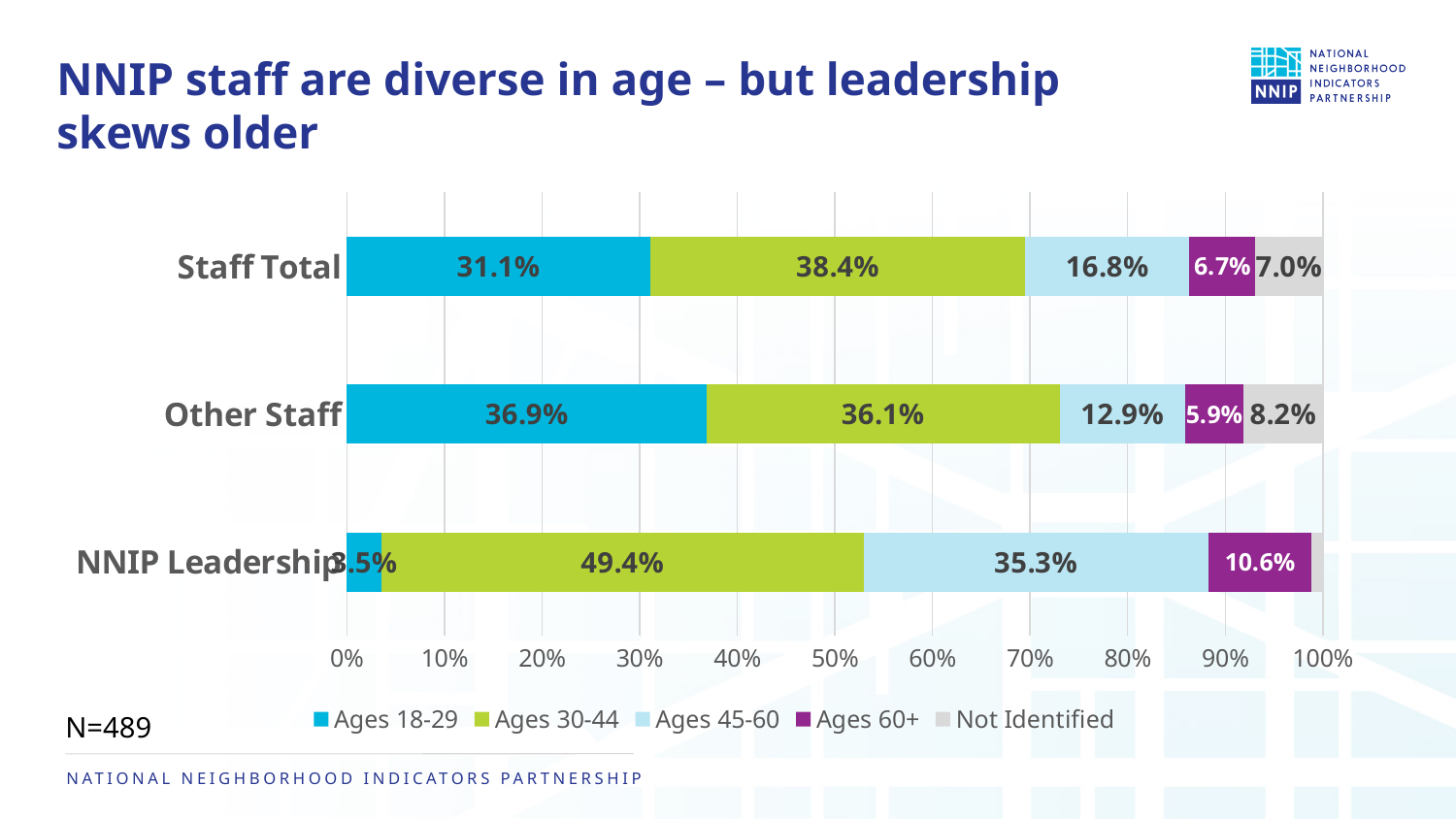
What is the Not Identified value for Other Staff? 8.2% Which is larger: the Ages 60+ value for NNIP Leadership or for Staff Total? NNIP Leadership What is the Ages 18-29 value for Other Staff? 36.9% What is the Ages 60+ value for Staff Total? 6.7% Which category has the highest Ages 45-60 value? NNIP Leadership What kind of chart is shown on the slide? Stacked bar chart What is the title of the chart slide? NNIP staff are diverse in age – but leadership skews older Which category has the lowest Ages 18-29 value? NNIP Leadership How many series does the legend list? 5 What is the difference between the Ages 45-60 values for NNIP Leadership and Other Staff? 22.4% How many categories (bars) are shown on the chart? 3 What is the Ages 30-44 value for NNIP Leadership? 49.4%